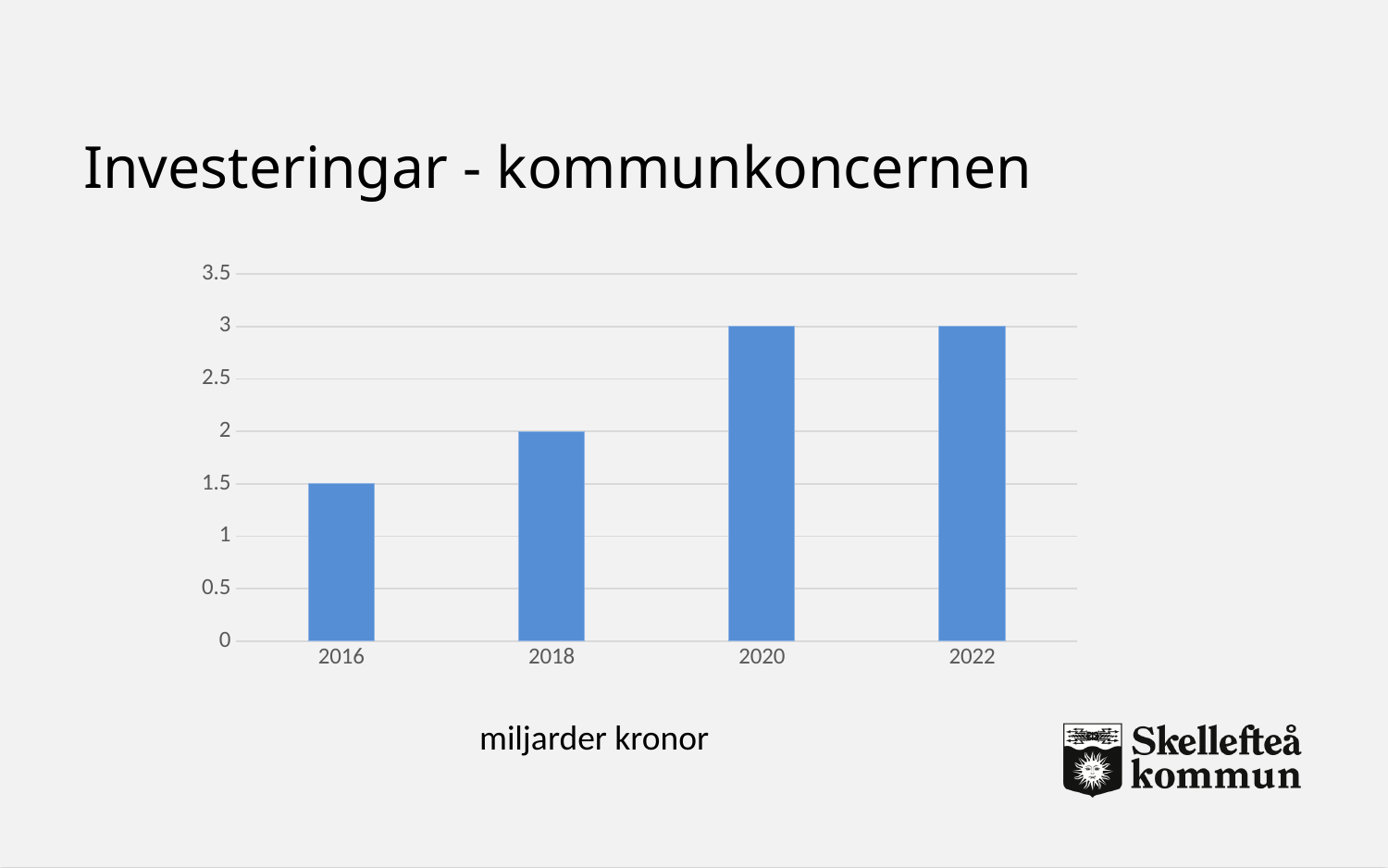
What type of chart is shown on the slide? bar chart What is the value for 2018? 2 What is the title of the chart? Investeringar - kommunkoncernen Is the value for 2022 greater or less than 2.5? greater What is the difference between the values for 2020 and 2016? 1.5 What is the value for 2020? 3 Which year has the lowest value? 2016 Do the values generally rise or fall from 2016 to 2022? rise What unit is given below the chart? miljarder kronor How many years are shown on the x axis? 4 Which is larger, the value for 2018 or the value for 2020? 2020 What is the value for 2016? 1.5